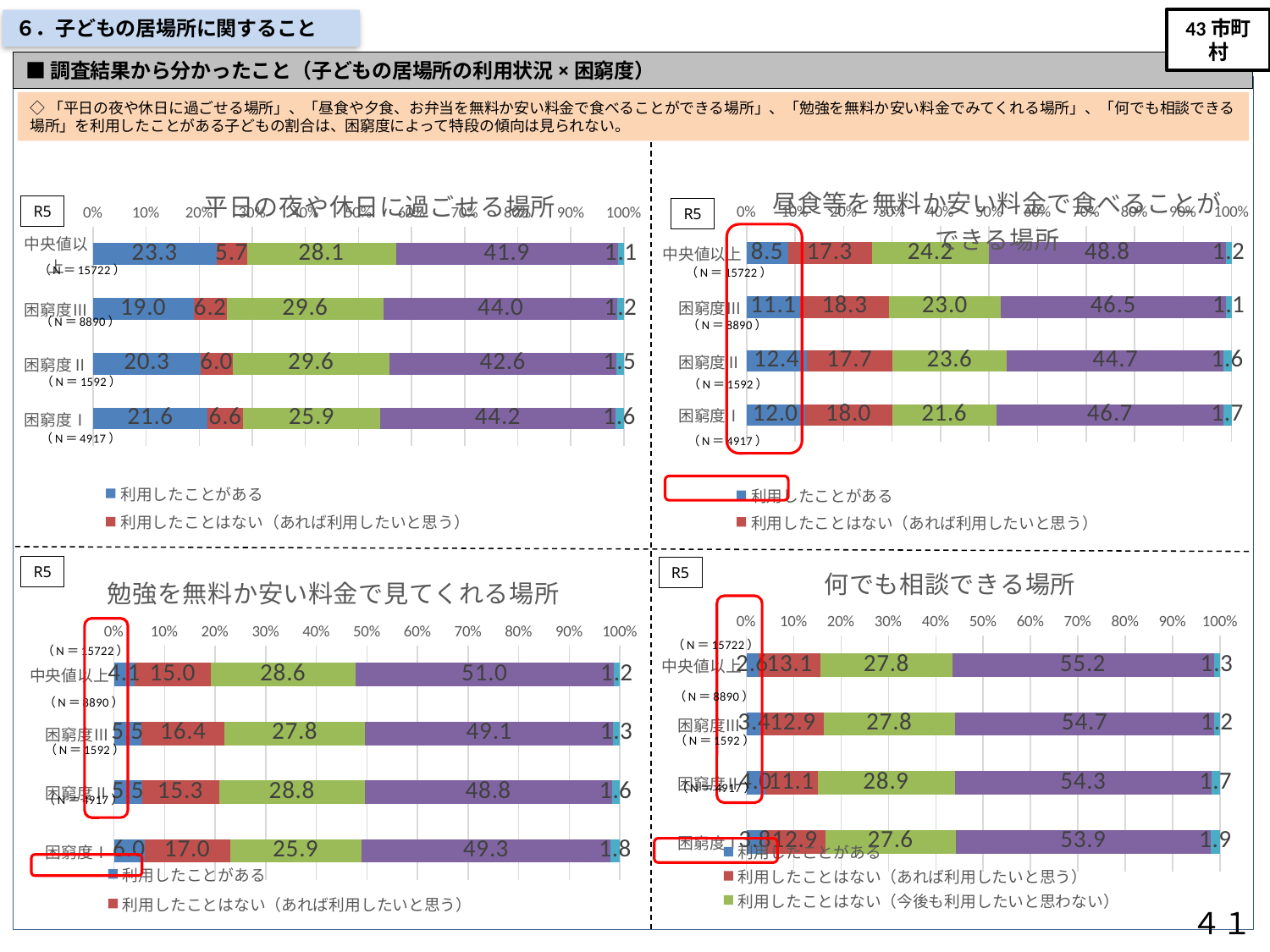
In the chart titled 平日の夜や休日に過ごせる場所, which category has the lowest value for 利用したことがある? 困窮度III In the chart titled 昼食等を無料か安い料金で食べることができる場所, what is the difference between the 利用したことがある values for 困窮度II and 中央値以上? 3.9 In the chart titled 勉強を無料か安い料金で見てくれる場所, what is the value of 利用したことはない（あれば利用したいと思う） for 困窮度I? 17.0 In the chart titled 昼食等を無料か安い料金で食べることができる場所, what is the value of 利用したことがある for 困窮度II? 12.4 In the chart titled 勉強を無料か安い料金で見てくれる場所, which category has the highest value for 利用したことがある? 困窮度I What type of chart is the chart titled 何でも相談できる場所? Stacked bar chart In the chart titled 平日の夜や休日に過ごせる場所, what is the value of 利用したことがある for 中央値以上? 23.3 How many categories are shown in the chart titled 平日の夜や休日に過ごせる場所? 4 In the chart titled 何でも相談できる場所, which category has the lowest value for 利用したことがある? 中央値以上 In the chart titled 平日の夜や休日に過ごせる場所, which category has the highest value for 利用したことがある? 中央値以上 In the chart titled 何でも相談できる場所, what is the value of 利用したことはない（今後も利用したいと思わない） for 困窮度II? 28.9 In the chart titled 何でも相談できる場所, which is larger, the 利用したことがある value for 困窮度II or for 中央値以上? 困窮度II